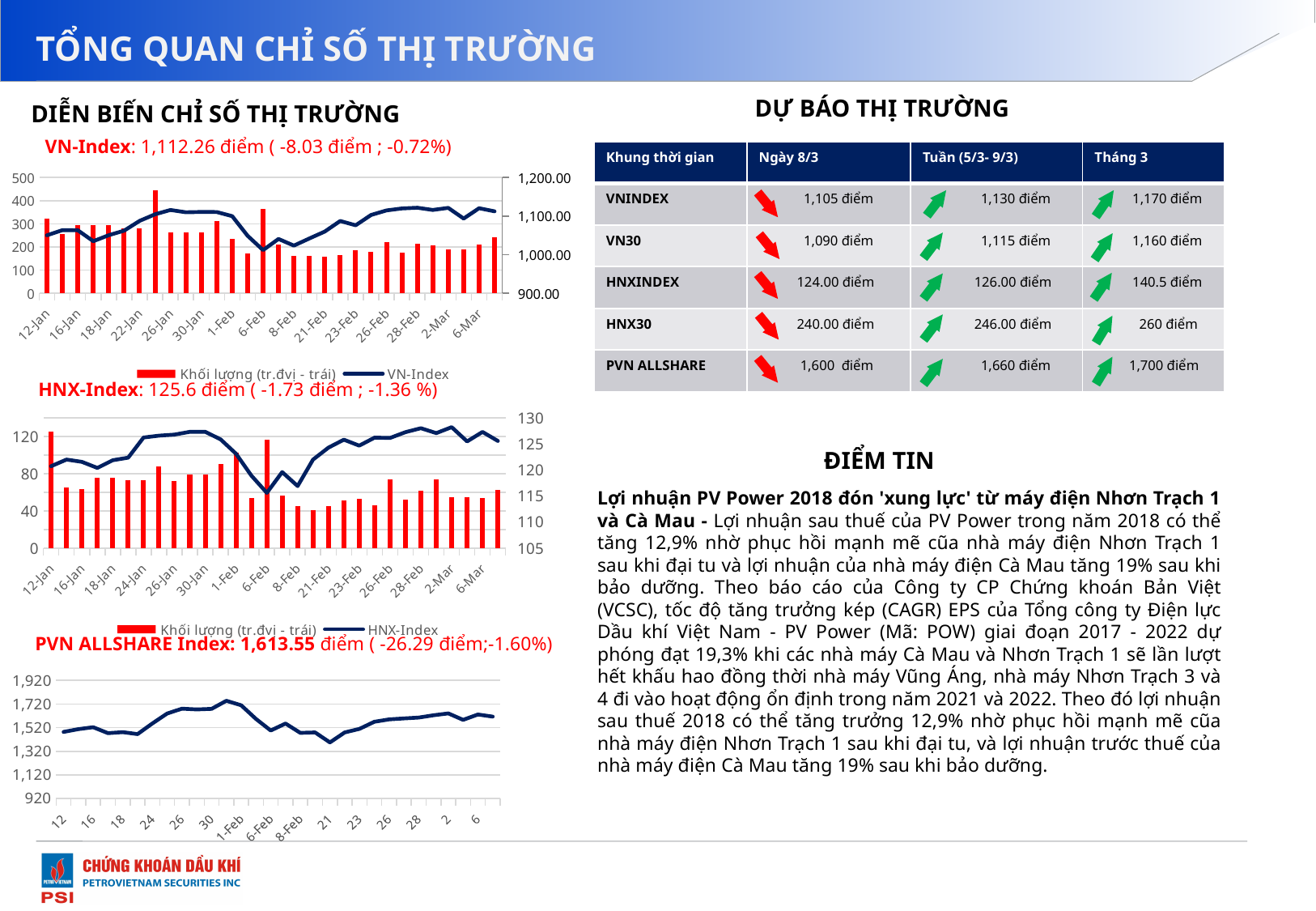
How many series does the legend of the VN-Index chart list? 2 In the VN-Index chart, is the VN-Index line value at 12-Jan greater or less than 1,000.00 on the right axis? greater In the PVN ALLSHARE Index chart, at which x-axis label does the line reach its lowest point? 21 What are the two legend entries of the HNX-Index chart? Khối lượng (tr.đvị - trái) and HNX-Index In the VN-Index chart, is the tallest volume bar greater or less than 400 on the left axis? greater What kind of chart is the VN-Index chart (top left)? Combination bar and line chart How many series does the legend of the HNX-Index chart list? 2 What kind of chart is the PVN ALLSHARE Index chart (bottom left)? Line chart In the HNX-Index chart, does the HNX-Index line end higher or lower at 6-Mar than it started at 12-Jan? higher In the PVN ALLSHARE Index chart, is the value at the x-axis label 21 greater or less than 1,520? less What index value is stated in the title of the PVN ALLSHARE Index chart? 1,613.55 điểm